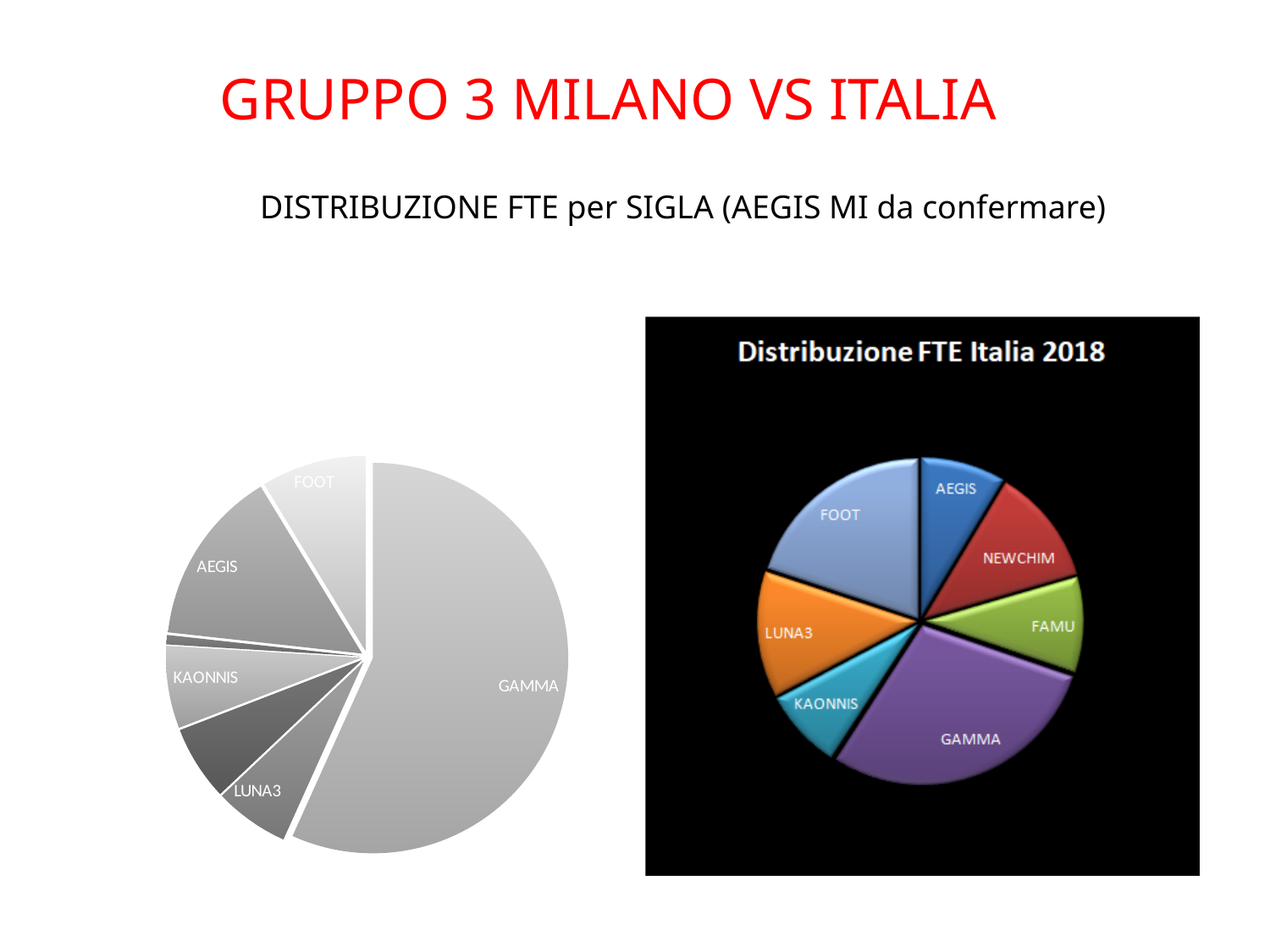
In the 'Distribuzione FTE Italia 2018' chart, which slice is larger, GAMMA or FAMU? GAMMA How many slices does the 'Distribuzione FTE Italia 2018' pie chart have? 7 In the 'Distribuzione FTE Italia 2018' chart, what colour is the GAMMA slice? purple In the 'Distribuzione FTE Italia 2018' chart, which category has the largest slice? GAMMA In the chart on the left of the slide, which slice is larger, GAMMA or AEGIS? GAMMA What is the title of the chart on the right of the slide? Distribuzione FTE Italia 2018 What kind of chart is the 'Distribuzione FTE Italia 2018' chart? pie chart In the chart on the left of the slide, which slice is larger, FOOT or LUNA3? FOOT In the chart on the left of the slide, which category has the largest slice? GAMMA What kind of chart is the chart on the left of the slide? pie chart